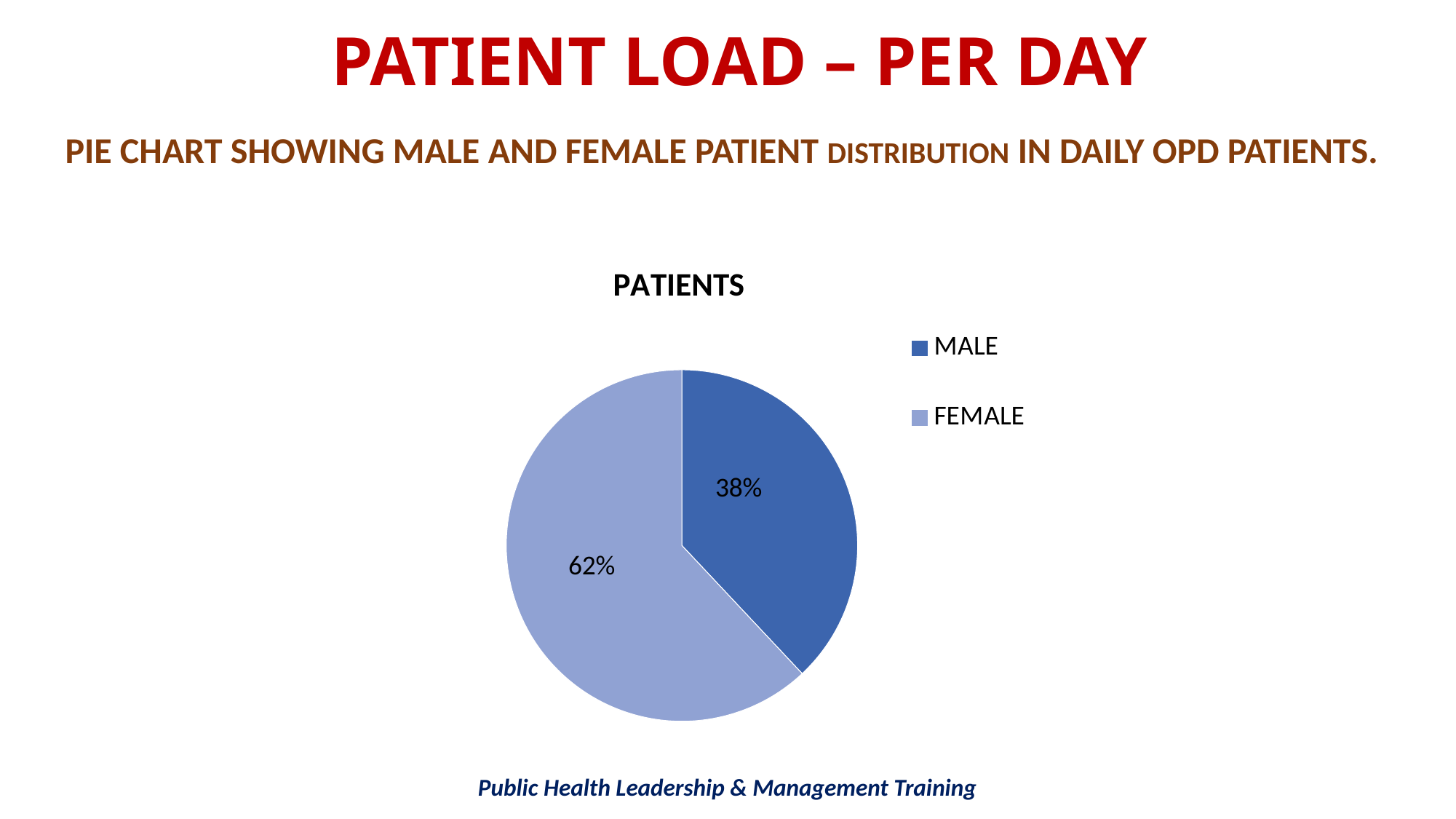
What share of the pie does the MALE slice represent? 38% Which is larger, the male share or the female share? FEMALE Which category has the smallest share of the pie? MALE What percentage of patients are male? 38% What is the difference in percentage points between the female and male shares? 24 What kind of chart is shown on the slide? Pie chart Which legend entry is shown in the lighter blue colour? FEMALE How many categories does the pie chart show? 2 How many entries does the legend list? 2 Which category has the largest share of the pie? FEMALE What percentage of patients are female? 62% What is the title of the chart? PATIENTS